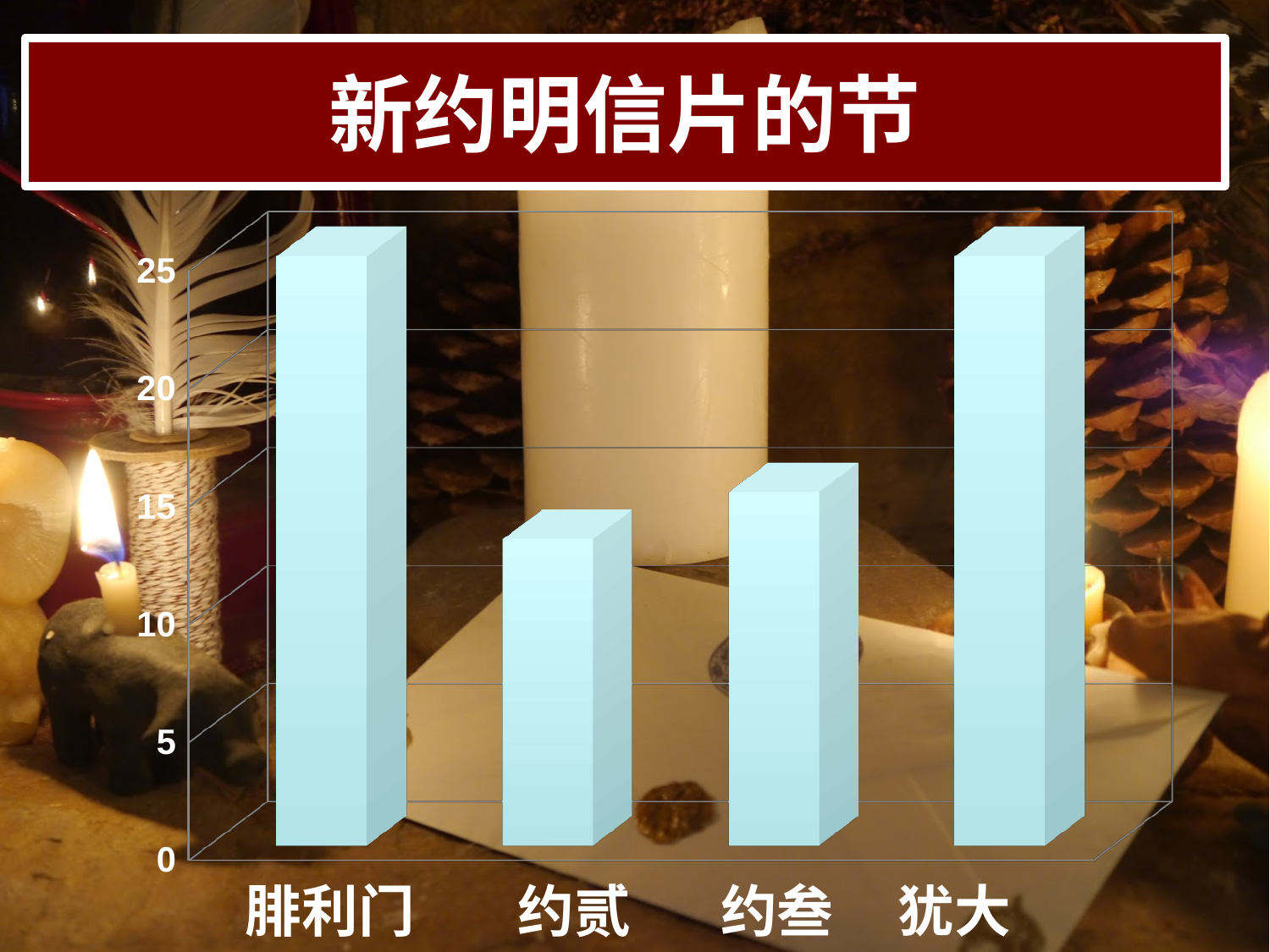
Is the value for 约叁 greater or less than 20? less What kind of chart is shown on the slide? bar chart What is the title of the chart on the slide? 新约明信片的节 Which bar is taller, 腓利门 or 约叁? 腓利门 Which bar is taller, 犹大 or 约贰? 犹大 Which bar is taller, 约贰 or 约叁? 约叁 How many categories are shown on the x axis of the chart? 4 Which category has the lowest bar in the chart? 约贰 Is the value for 约贰 greater or less than 15? less Is the value for 犹大 greater or less than 20? greater